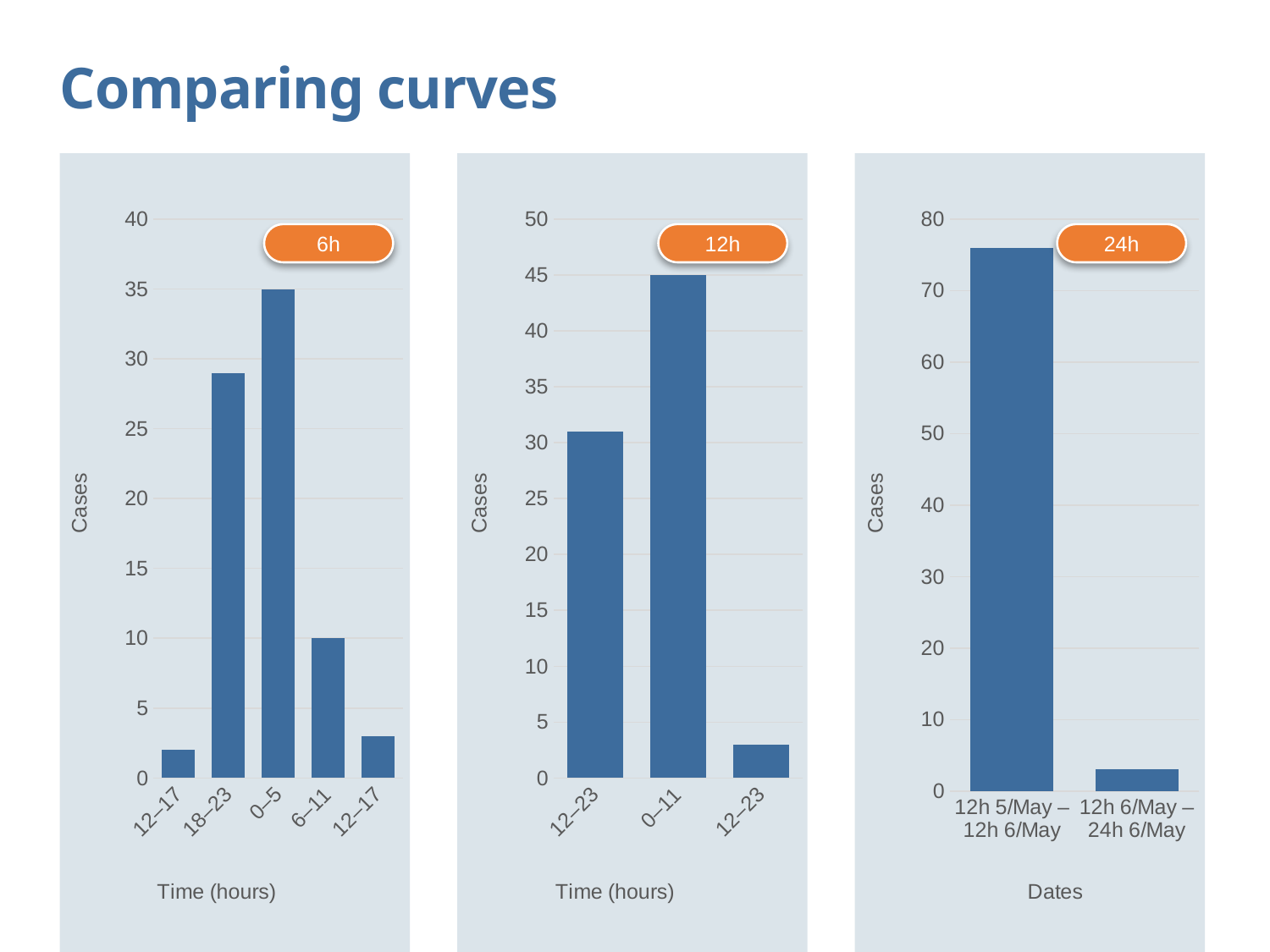
In the 24h chart on the right, is the value for 12h 6/May – 24h 6/May greater or less than 10? less In the 6h chart on the left, what is the number of cases for the 6–11 time bin? 10 In the 24h chart on the right, is the value for 12h 5/May – 12h 6/May greater or less than 70? greater In the 6h chart on the left, what is the number of cases for the 0–5 time bin? 35 How many categories are shown on the x axis of the 12h chart in the middle? 3 In the 12h chart in the middle, what is the number of cases for the 0–11 time bin? 45 How many time bins are shown on the x axis of the 6h chart on the left? 5 In the 6h chart on the left, which time bin has the highest number of cases? 0–5 In the 12h chart in the middle, which time bin has the highest number of cases? 0–11 What kind of chart is the 24h chart on the right? Bar chart In the 6h chart on the left, is the value for the 18–23 time bin greater or less than 25? greater In the 24h chart on the right, which date range has the higher number of cases? 12h 5/May – 12h 6/May